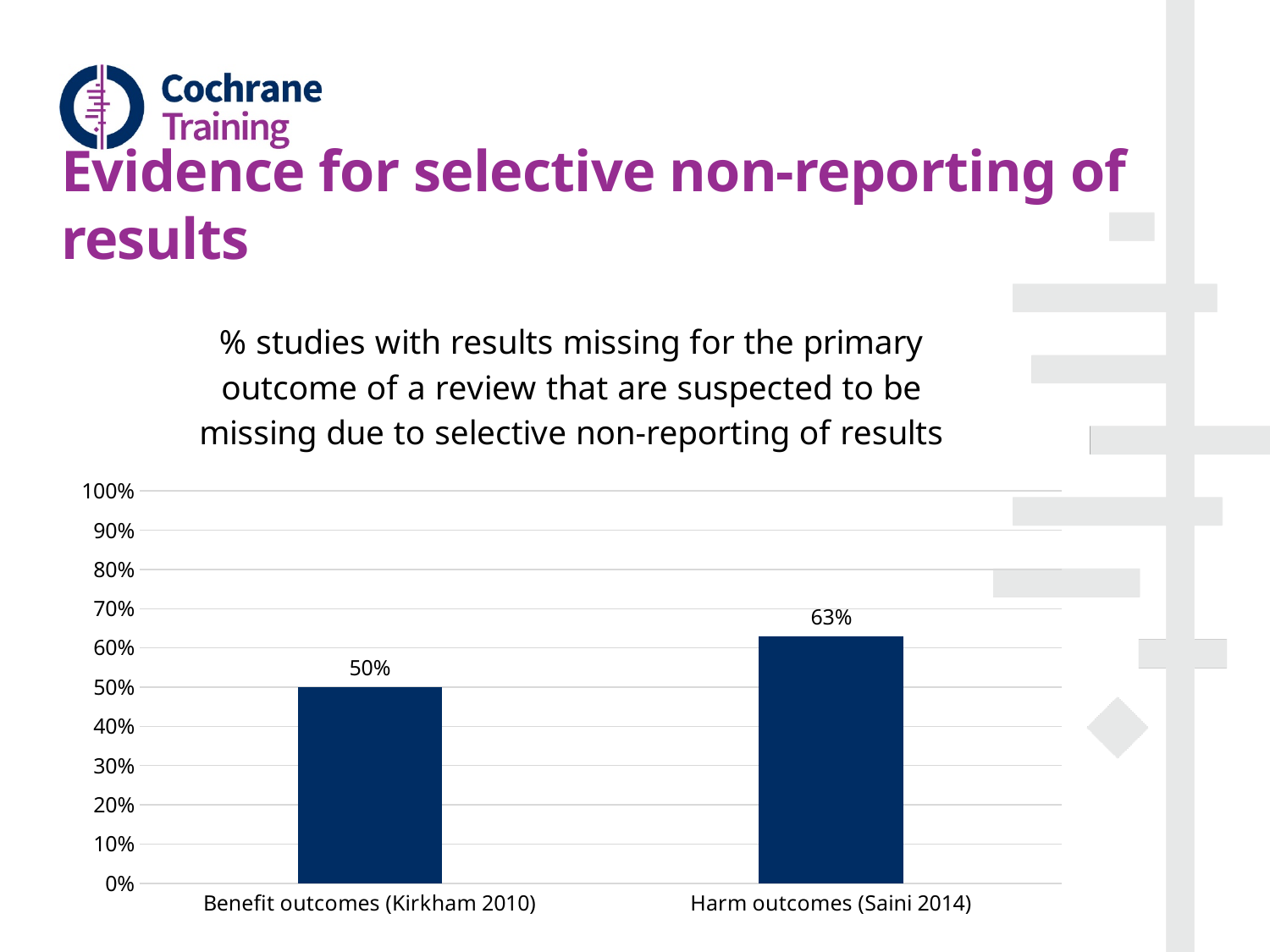
What is the maximum value shown on the y axis? 100% Which category has the lowest value? Benefit outcomes (Kirkham 2010) Is the value for Harm outcomes (Saini 2014) greater or less than 70%? less What is the value for Benefit outcomes (Kirkham 2010)? 50% What is the value for Harm outcomes (Saini 2014)? 63% Which category has the highest value? Harm outcomes (Saini 2014) How many categories are shown on the x axis? 2 Is the value for Benefit outcomes (Kirkham 2010) greater or less than 40%? greater What kind of chart is shown on the slide? bar chart What colour are the bars in the chart? dark blue Which is larger, the value for Benefit outcomes (Kirkham 2010) or the value for Harm outcomes (Saini 2014)? Harm outcomes (Saini 2014) What is the difference between the values for Harm outcomes (Saini 2014) and Benefit outcomes (Kirkham 2010)? 13%